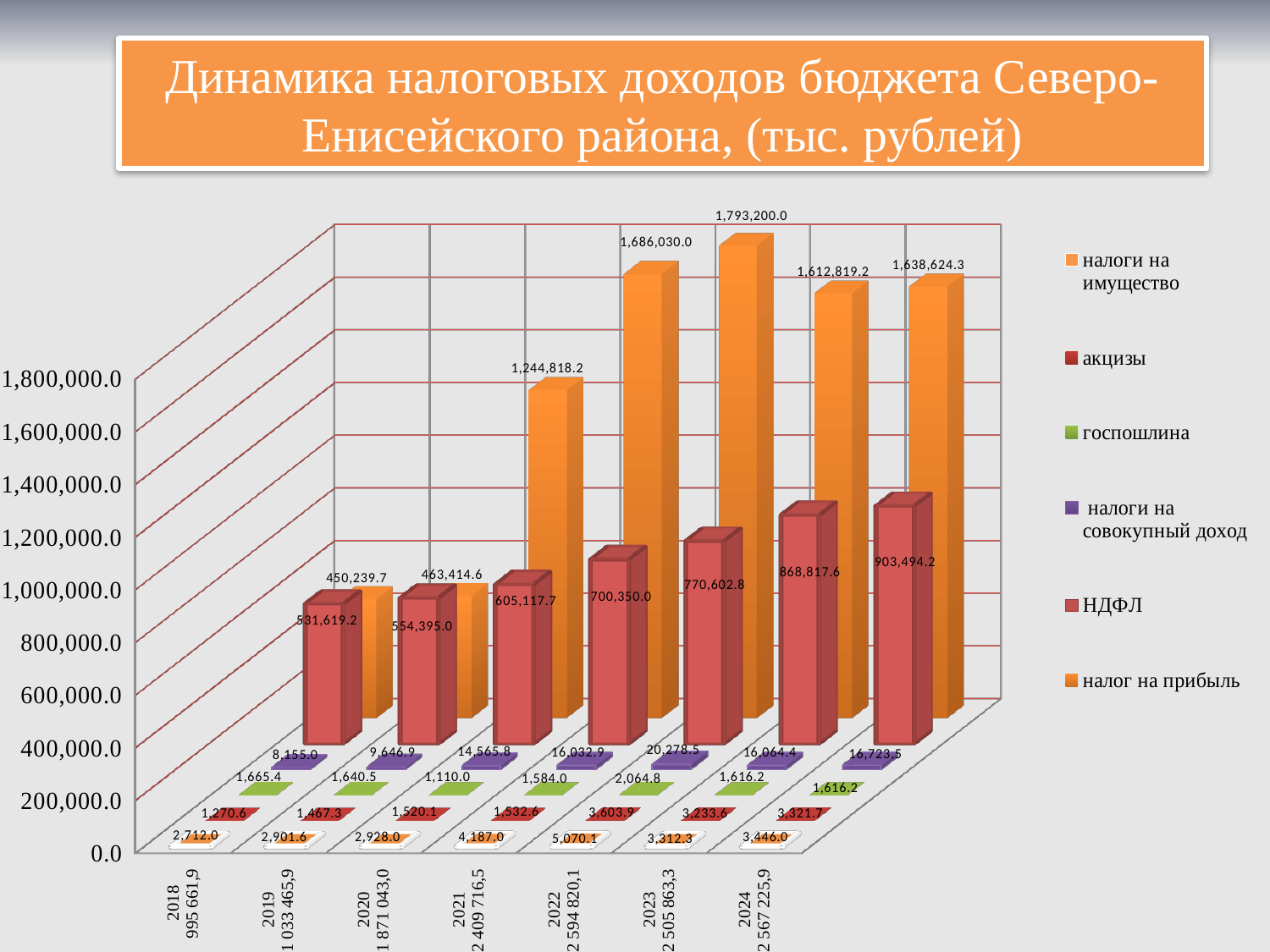
What type of chart is shown on the slide? bar chart In which year is налог на прибыль highest? 2022 What is the value of налог на прибыль for 2022? 1,793,200.0 In which year is НДФЛ lowest? 2018 What is the difference between НДФЛ in 2024 and НДФЛ in 2018? 371,875.0 Does НДФЛ rise or fall from 2018 to 2024? rise What is the value of госпошлина for 2022? 2,064.8 What is the value of налоги на совокупный доход for 2020? 14,565.8 How many series does the legend list? 6 How many years are shown on the x axis? 7 Which is larger: налог на прибыль in 2023 or налог на прибыль in 2024? 2024 What is the value of НДФЛ for 2024? 903,494.2